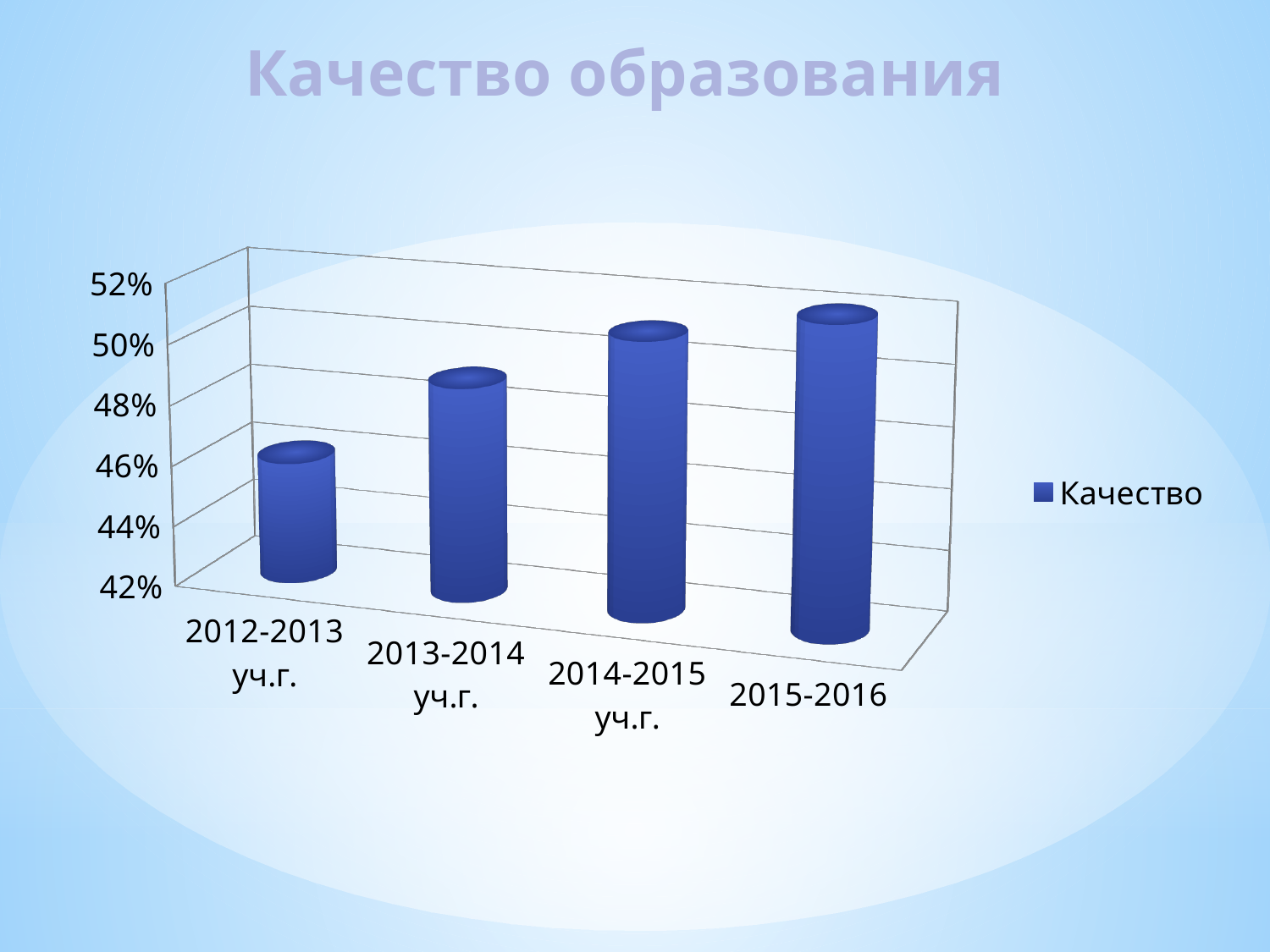
What kind of chart is shown on the slide? bar chart Is the value for 2013-2014 уч.г. greater or less than 44%? greater Which is larger, the value for 2014-2015 уч.г. or the value for 2012-2013 уч.г.? 2014-2015 уч.г. Which category has the highest value? 2015-2016 Is the value for 2012-2013 уч.г. greater or less than 48%? less Is the value for 2015-2016 greater or less than 48%? greater Which category has the lowest value? 2012-2013 уч.г. How many categories are shown on the x axis? 4 What is the title of the chart? Качество образования Do the values rise or fall from 2012-2013 уч.г. to 2015-2016? rise How many series does the legend list? 1 What is the name of the series in the legend? Качество